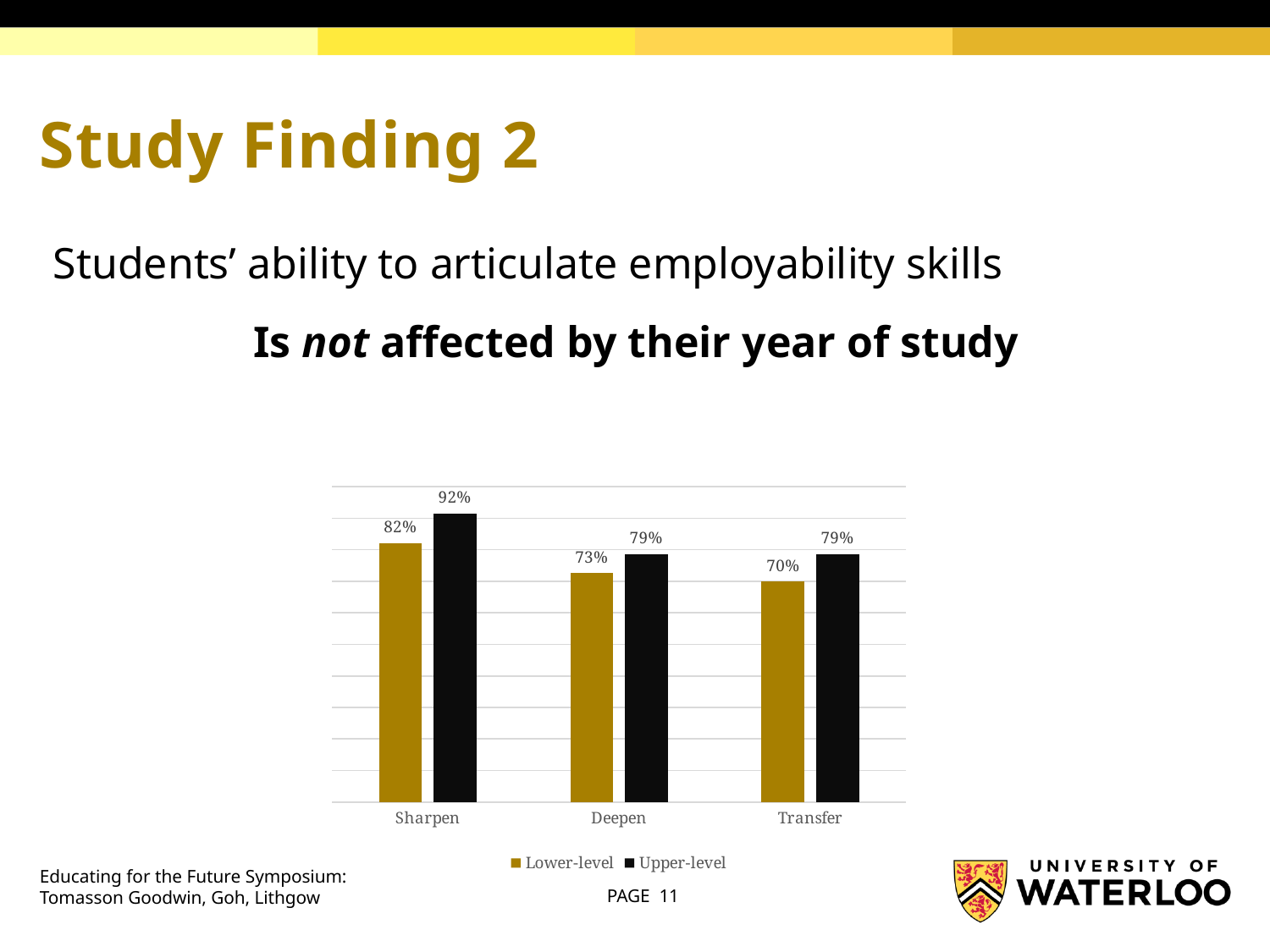
What is the difference between the Lower-level values for Sharpen and Transfer? 12% What is the Lower-level value for Transfer? 70% What is the difference between the Upper-level and Lower-level values for Sharpen? 10% Which colour represents the Upper-level series in the legend? Black Which category has the lowest Lower-level value? Transfer Which is larger for Deepen, the Lower-level value or the Upper-level value? Upper-level How many categories are shown on the x axis? 3 How many series does the legend list? 2 What is the Lower-level value for Sharpen? 82% What kind of chart is shown on the slide? Bar chart What is the Upper-level value for Deepen? 79% Which category has the highest Upper-level value? Sharpen